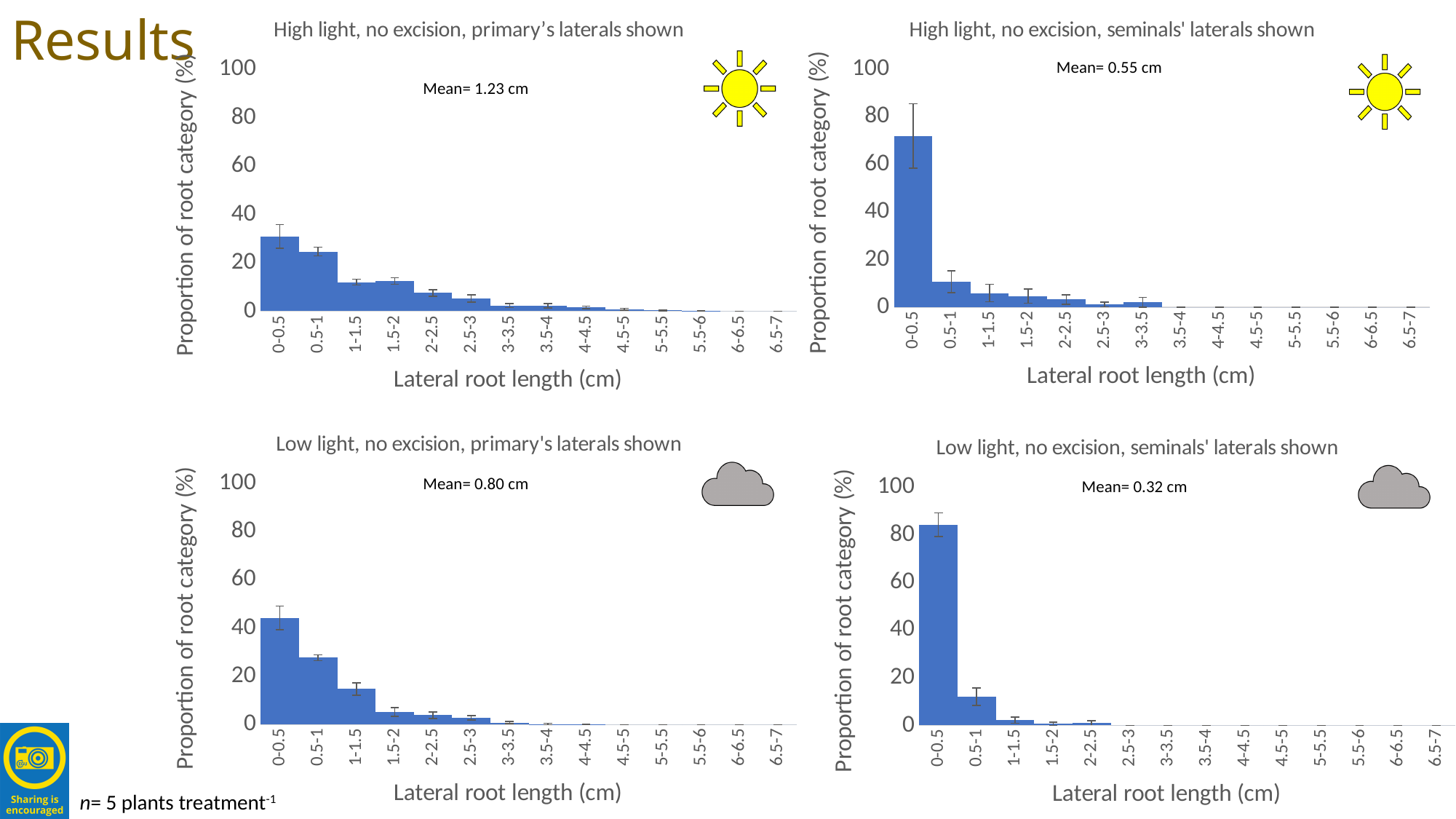
In the bottom-left chart (Low light, primary's laterals), do the proportions rise or fall as lateral root length increases along the x axis? fall In the bottom-left chart (Low light, primary's laterals), which lateral root length category has the highest proportion? 0-0.5 In the top-right chart (High light, seminals' laterals), which lateral root length category has the highest proportion? 0-0.5 What kind of chart is the top-left chart, 'High light, no excision, primary's laterals shown'? bar chart In the bottom-left chart (Low light, primary's laterals), what mean lateral root length is printed on the chart? Mean= 0.80 cm In the bottom-right chart (Low light, seminals' laterals), is the value for the 0.5-1 category greater or less than 20? less In the bottom-right chart (Low light, seminals' laterals), what mean lateral root length is printed on the chart? Mean= 0.32 cm In the top-left chart (High light, primary's laterals), what mean lateral root length is printed on the chart? Mean= 1.23 cm In the top-left chart (High light, primary's laterals), is the value for the 0-0.5 category greater or less than 20? greater In the top-right chart (High light, seminals' laterals), is the value for the 0-0.5 category greater or less than 60? greater How many lateral root length categories are shown on the x axis of the bottom-left chart (Low light, primary's laterals)? 14 In the top-right chart (High light, seminals' laterals), what mean lateral root length is printed on the chart? Mean= 0.55 cm